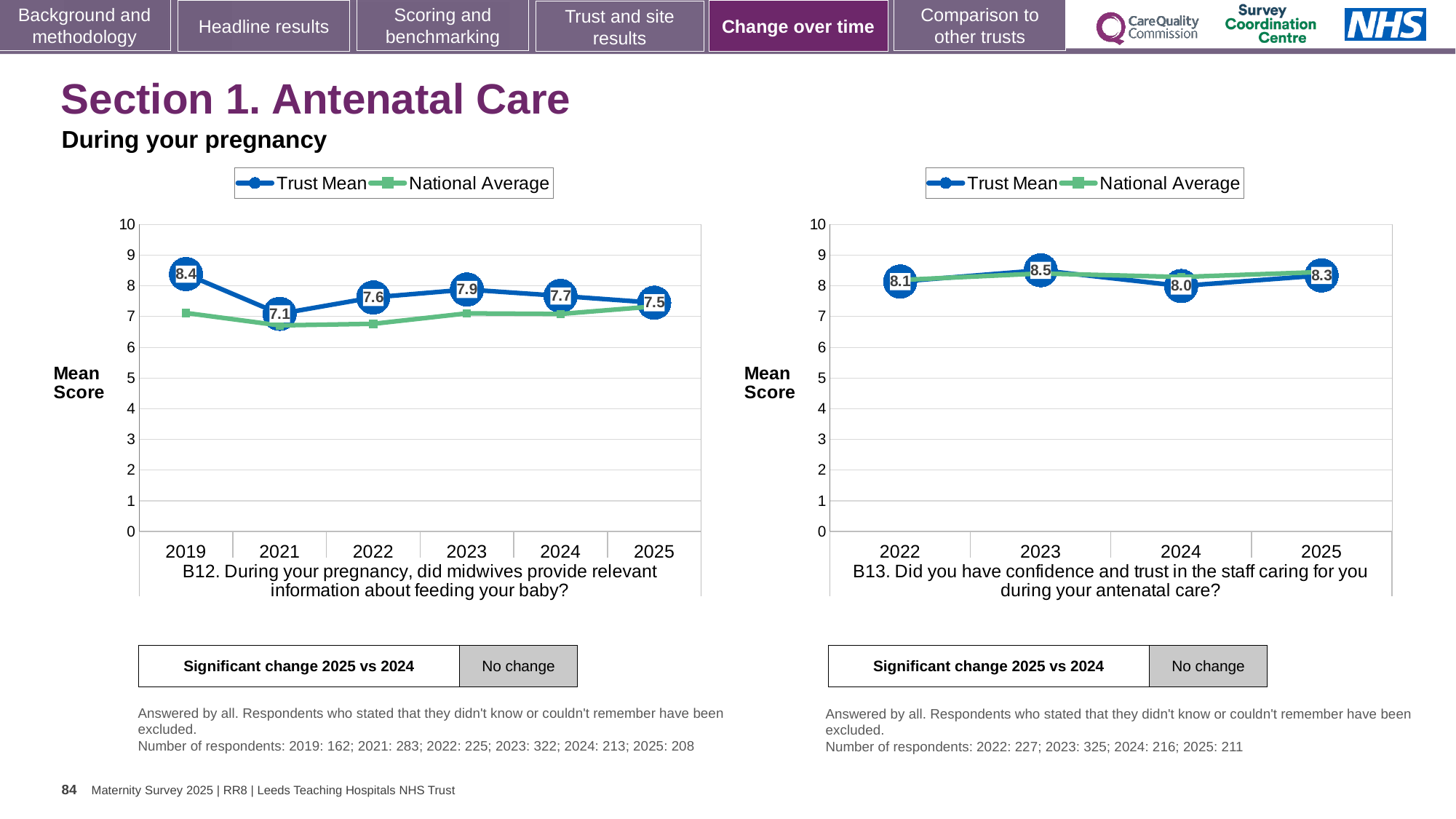
In the B13 chart (right), which year has the lowest Trust Mean? 2024 In the B13 chart (right), how many series does the legend list? 2 In the B12 chart (left), what is the Trust Mean for 2019? 8.4 What kind of chart is the B13 chart (right)? Line chart In the B12 chart (left), what is the difference between the Trust Mean for 2019 and 2021? 1.3 In the B12 chart (left), is the National Average for 2019 greater or less than 8? less In the B12 chart (left), how many years are plotted on the x axis? 6 In the B13 chart (right), what is the difference between the Trust Mean for 2023 and 2024? 0.5 In the B12 chart (left), which year has the highest Trust Mean? 2019 In the B12 chart (left), what is the Trust Mean for 2025? 7.5 In the B12 chart (left), which year has the lowest Trust Mean? 2021 In the B13 chart (right), what is the Trust Mean for 2023? 8.5